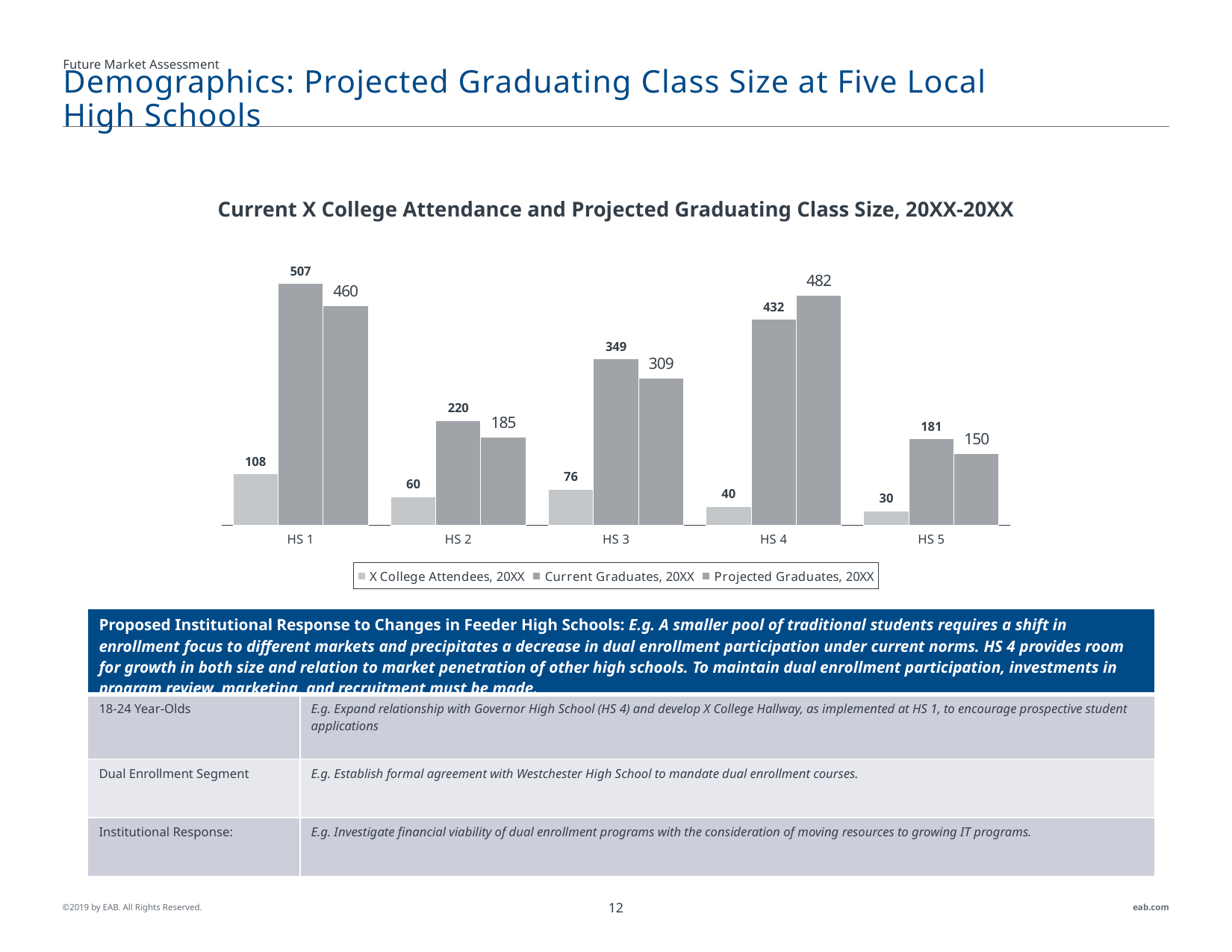
What is the value for Projected Graduates, 20XX at HS 4? 482 Which high school has the lowest value for X College Attendees, 20XX? HS 5 How many high schools are shown on the x axis? 5 What is the value for Current Graduates, 20XX at HS 3? 349 What is the difference between X College Attendees, 20XX at HS 1 and at HS 5? 78 How many series does the legend list? 3 What is the title of the chart? Current X College Attendance and Projected Graduating Class Size, 20XX-20XX What is the value for X College Attendees, 20XX at HS 1? 108 What kind of chart is shown on the slide? Bar chart Which is larger at HS 4: Current Graduates, 20XX or Projected Graduates, 20XX? Projected Graduates, 20XX What is the difference between Current Graduates, 20XX and Projected Graduates, 20XX at HS 2? 35 Which high school has the highest value for Current Graduates, 20XX? HS 1